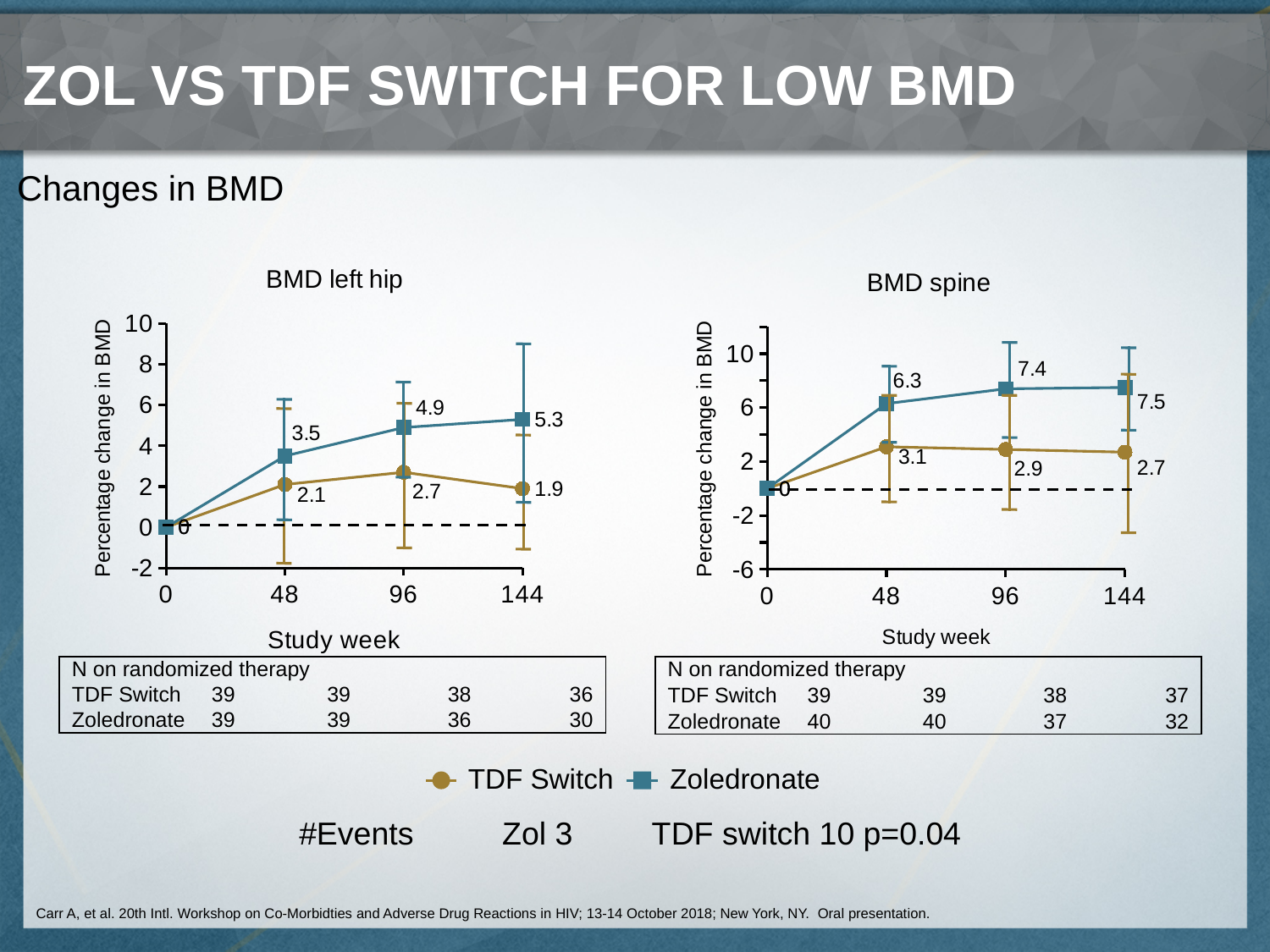
In the BMD spine chart, which series has the larger value at study week 48, TDF Switch or Zoledronate? Zoledronate In the BMD spine chart, what is the percentage change in BMD for Zoledronate at study week 48? 6.3 In the BMD left hip chart, at which study week after baseline is the TDF Switch value lowest? 144 In the BMD left hip chart, what is the difference between the Zoledronate and TDF Switch values at study week 144? 3.4 In the BMD spine chart, does the TDF Switch series rise or fall between study week 48 and study week 144? fall In the BMD spine chart, what is the difference between the Zoledronate and TDF Switch values at study week 96? 4.5 In the BMD left hip chart, what is the percentage change in BMD for Zoledronate at study week 144? 5.3 How many series does the legend list? 2 In the BMD left hip chart, what is the percentage change in BMD for TDF Switch at study week 96? 2.7 What kind of chart is the BMD left hip chart? line chart In the BMD spine chart, what is the percentage change in BMD for TDF Switch at study week 144? 2.7 In the BMD spine chart, at which study week does Zoledronate reach its highest percentage change in BMD? 144